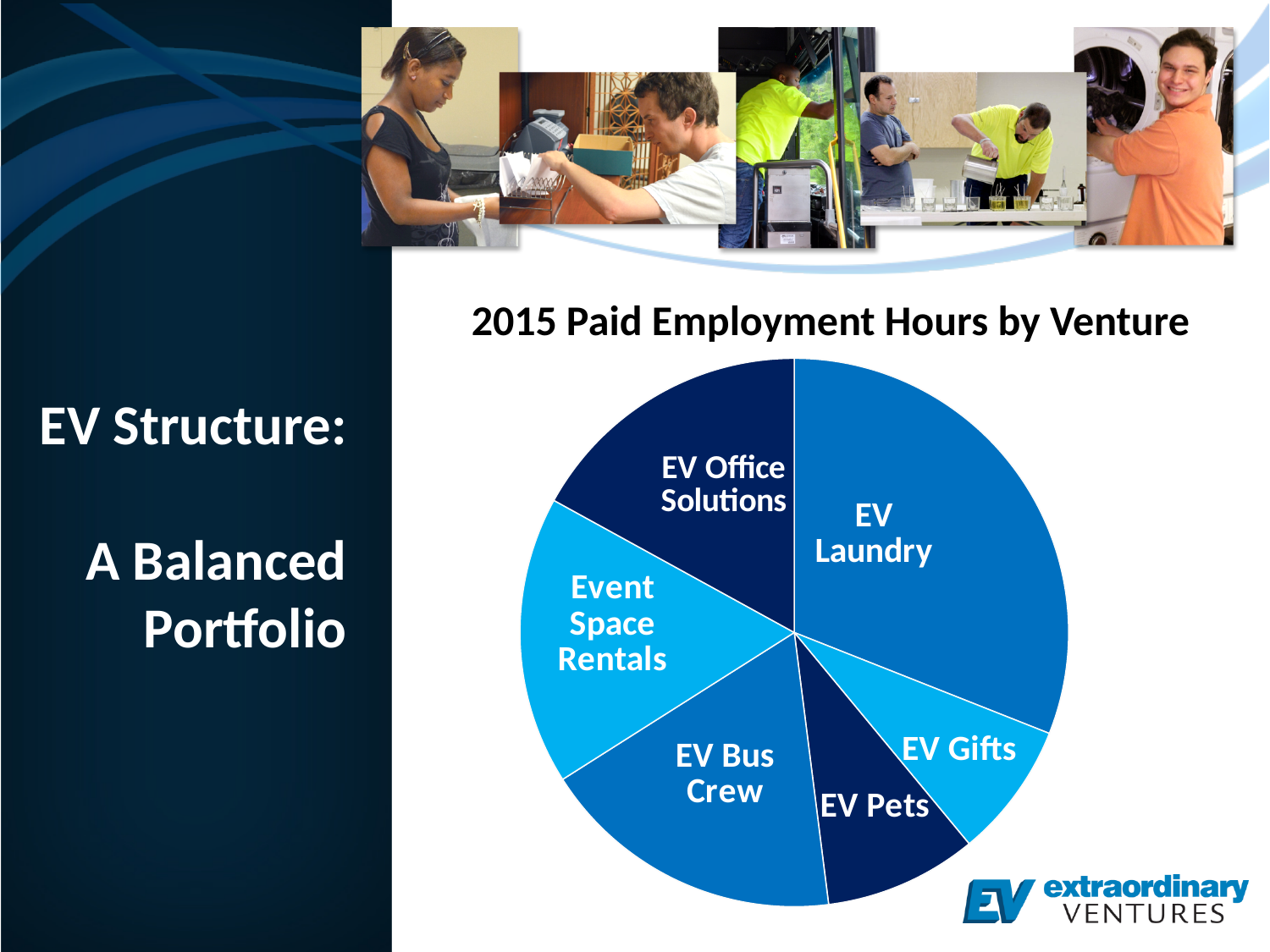
Which has the larger share of paid employment hours, EV Laundry or EV Gifts? EV Laundry Which has the larger share of paid employment hours, EV Office Solutions or EV Pets? EV Office Solutions What is the title of the chart? 2015 Paid Employment Hours by Venture Which has the larger share of paid employment hours, EV Bus Crew or EV Gifts? EV Bus Crew What kind of chart is shown on the slide? Pie chart How many ventures (slices) are shown in the pie chart? 6 Which venture has the largest share of paid employment hours? EV Laundry